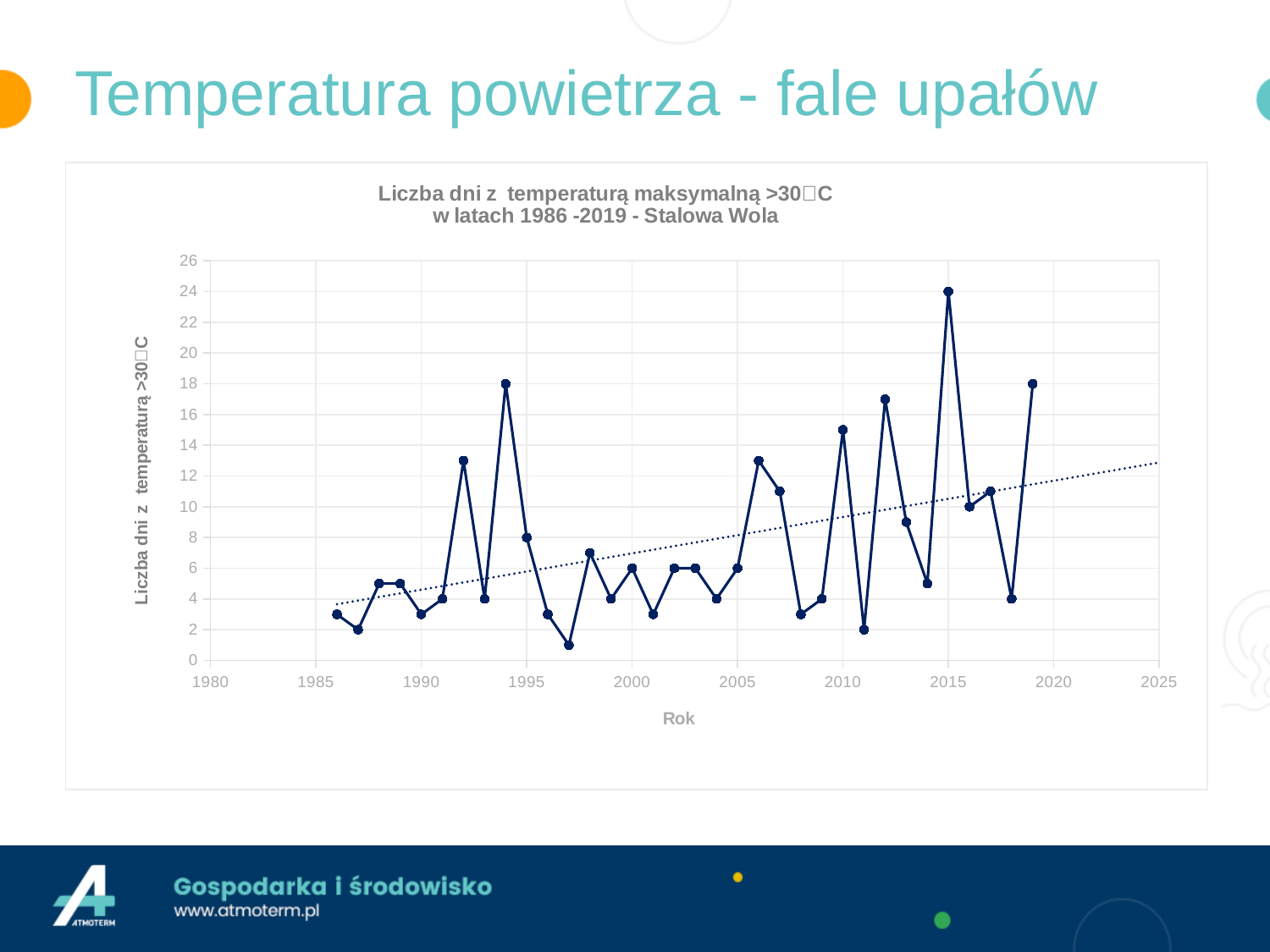
Which year has the larger value, 2015 or 2000? 2015 What is the title of the chart? Liczba dni z temperaturą maksymalną >30°C w latach 1986 -2019 - Stalowa Wola What is the value for the year 1995? 8 What is the value for the year 2000? 6 What is the difference between the values for 2015 and 1995? 16 In which year does the chart reach its highest value? 2015 What type of chart is shown on the slide? line chart Is the value for 2010 greater or less than 10? greater Does the dotted trend line rise or fall from left to right? rises What is the label of the x axis? Rok What is the highest value plotted on the chart? 24 What is the value for the year 2015? 24